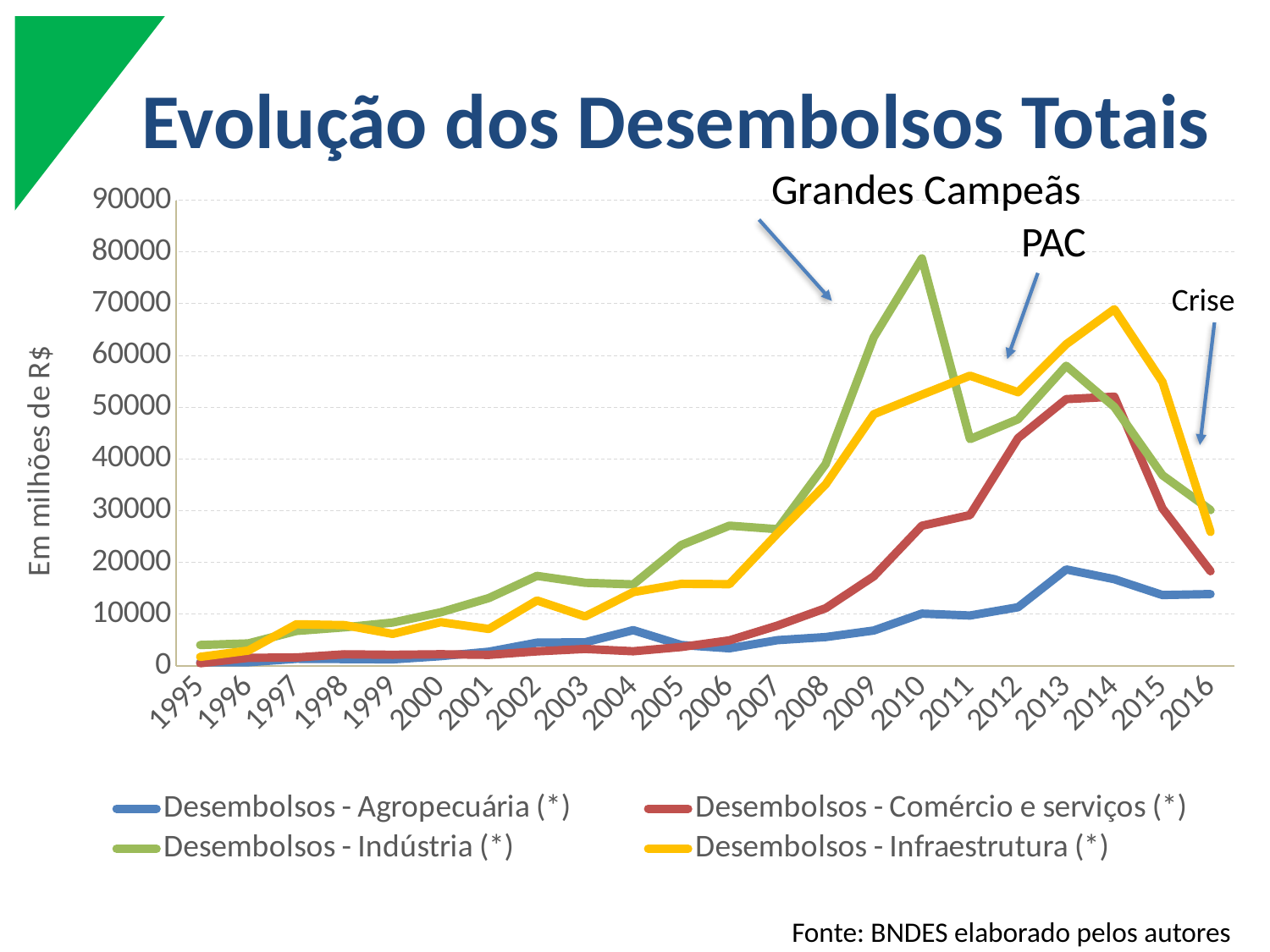
How many years are plotted along the x axis? 22 Is the value for Desembolsos - Indústria (*) in 2010 greater or less than 70000? greater What is the label on the vertical axis? Em milhões de R$ In 2010, which is larger: Desembolsos - Indústria (*) or Desembolsos - Infraestrutura (*)? Desembolsos - Indústria (*) How many series does the legend list? 4 Does the Desembolsos - Infraestrutura (*) series rise or fall from 2014 to 2016? fall What kind of chart is shown on the slide? line chart Is the value for Desembolsos - Agropecuária (*) in 2013 greater or less than 20000? less Is the value for Desembolsos - Infraestrutura (*) in 2014 greater or less than 60000? greater Which series has the lowest value in 2014? Desembolsos - Agropecuária (*) In 2016, which is larger: Desembolsos - Agropecuária (*) or Desembolsos - Comércio e serviços (*)? Desembolsos - Comércio e serviços (*)